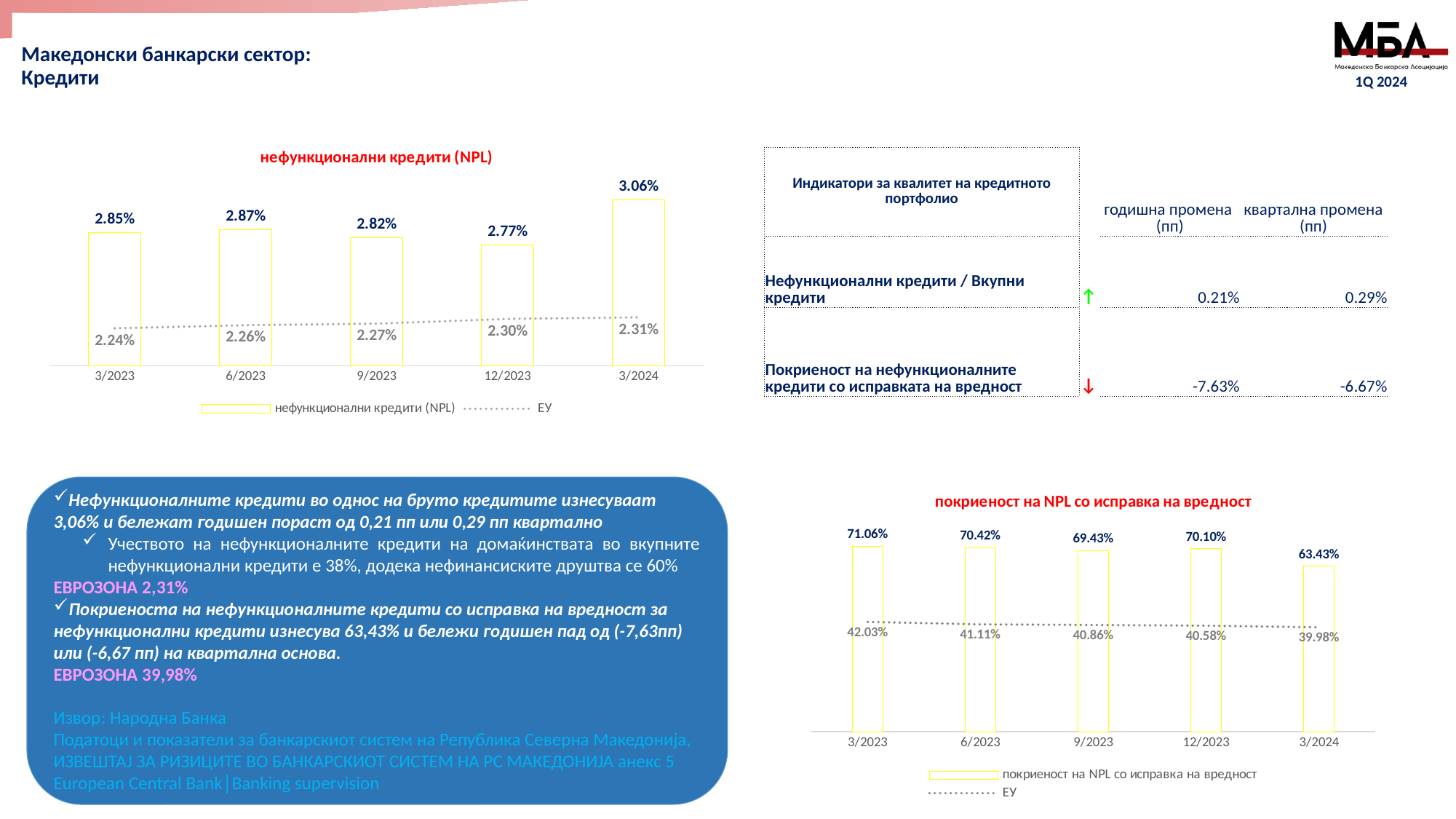
In the chart titled 'нефункционални кредити (NPL)', which period has the lowest NPL bar? 12/2023 What kind of chart is the one titled 'покриеност на NPL со исправка на вредност'? bar chart with a line In the chart titled 'нефункционални кредити (NPL)', what is the difference between the NPL value and the ЕУ value for 3/2024? 0.75% In the chart titled 'покриеност на NPL со исправка на вредност', what is the coverage value for 3/2024? 63.43% In the chart titled 'нефункционални кредити (NPL)', what is the ЕУ value for 12/2023? 2.30% In the chart titled 'нефункционални кредити (NPL)', how many periods are shown on the x axis? 5 In the chart titled 'нефункционални кредити (NPL)', which period has the highest NPL bar? 3/2024 In the chart titled 'нефункционални кредити (NPL)', how many series does the legend list? 2 In the chart titled 'покриеност на NPL со исправка на вредност', which period has the highest coverage bar? 3/2023 In the chart titled 'покриеност на NPL со исправка на вредност', what is the ЕУ value for 3/2023? 42.03% In the chart titled 'покриеност на NPL со исправка на вредност', does the ЕУ line rise or fall from 3/2023 to 3/2024? fall In the chart titled 'нефункционални кредити (NPL)', what is the NPL value for 3/2024? 3.06%